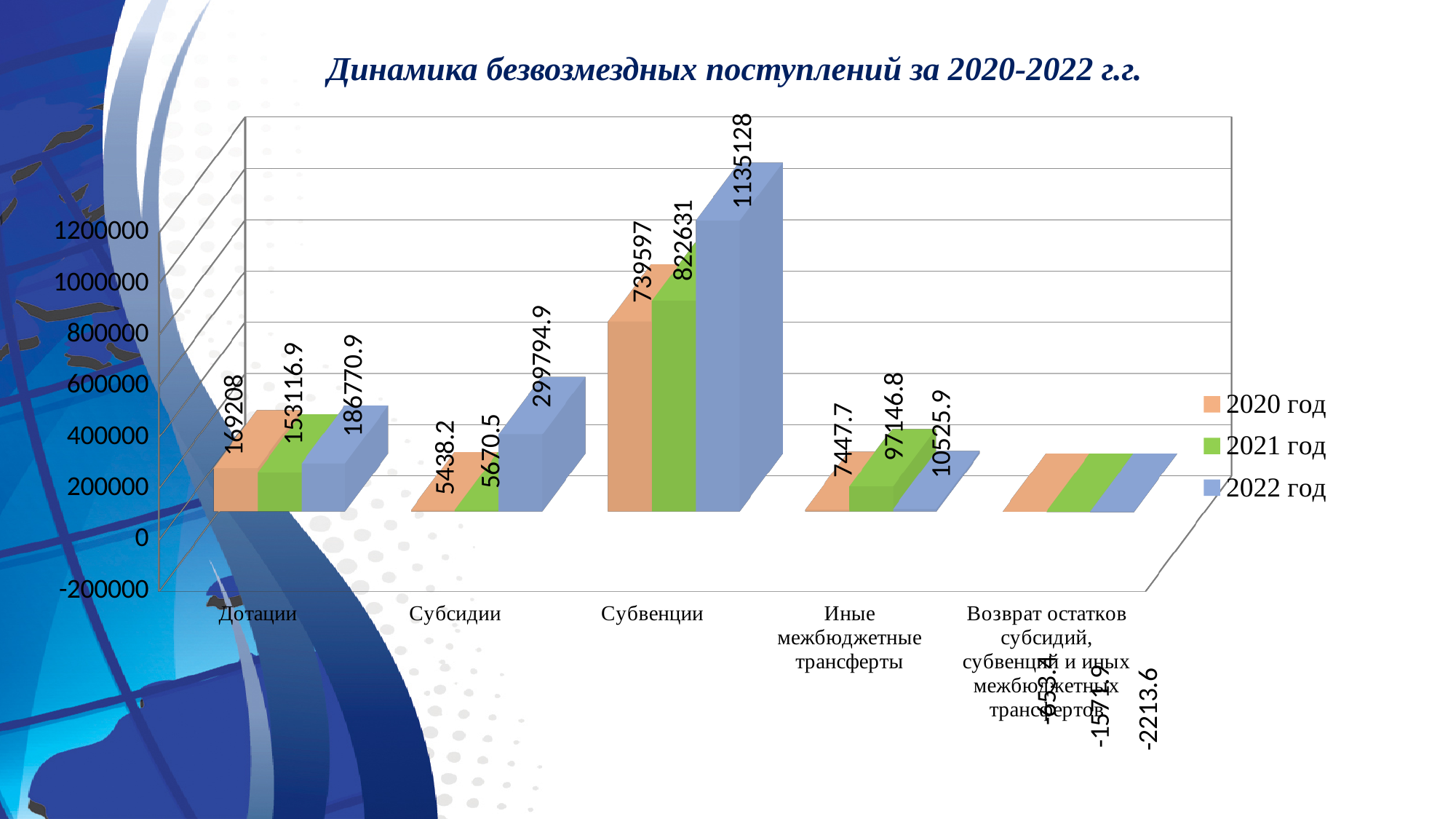
What kind of chart is shown on the slide? Bar chart What is the difference between the 2022 год and 2021 год values for Субвенции? 312497 How many categories are shown on the x axis? 5 What is the value for Субвенции in 2022 год? 1135128 What is the value for Дотации in 2021 год? 153116.9 How many series does the legend list? 3 What is the value for Субсидии in 2022 год? 299794.9 Which category has the lowest value for 2022 год? Возврат остатков субсидий, субвенций и иных межбюджетных трансфертов Which is larger for Дотации: the 2020 год value or the 2022 год value? 2022 год Do the values for Субвенции rise or fall from 2020 год to 2022 год? Rise What is the value for Иные межбюджетные трансферты in 2021 год? 97146.8 Which category has the highest value for 2022 год? Субвенции